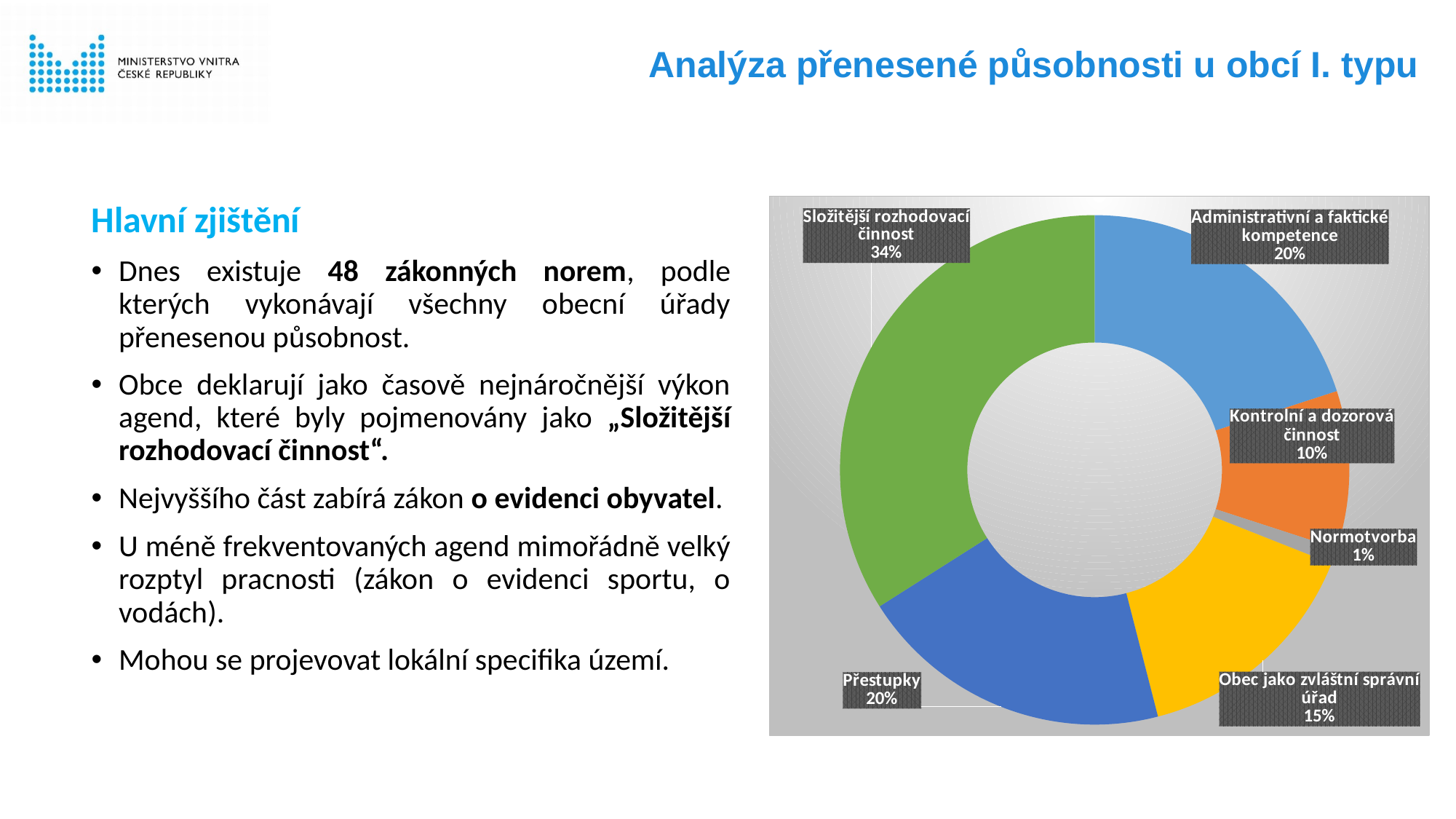
Which category has the largest share in the chart? Složitější rozhodovací činnost What percentage is shown for 'Obec jako zvláštní správní úřad'? 15% Do 'Přestupky' and 'Administrativní a faktické kompetence' have the same share? Yes, both 20% What percentage is shown for 'Normotvorba'? 1% What share of the chart does 'Složitější rozhodovací činnost' take? 34% How many categories are shown in the chart? 6 What kind of chart is shown on the slide? doughnut chart Which category has the smallest share in the chart? Normotvorba What percentage is shown for 'Kontrolní a dozorová činnost'? 10% What colour is the slice for 'Složitější rozhodovací činnost'? green Which is larger: the share for 'Obec jako zvláštní správní úřad' or for 'Kontrolní a dozorová činnost'? Obec jako zvláštní správní úřad What is the difference in percentage points between 'Složitější rozhodovací činnost' and 'Přestupky'? 14